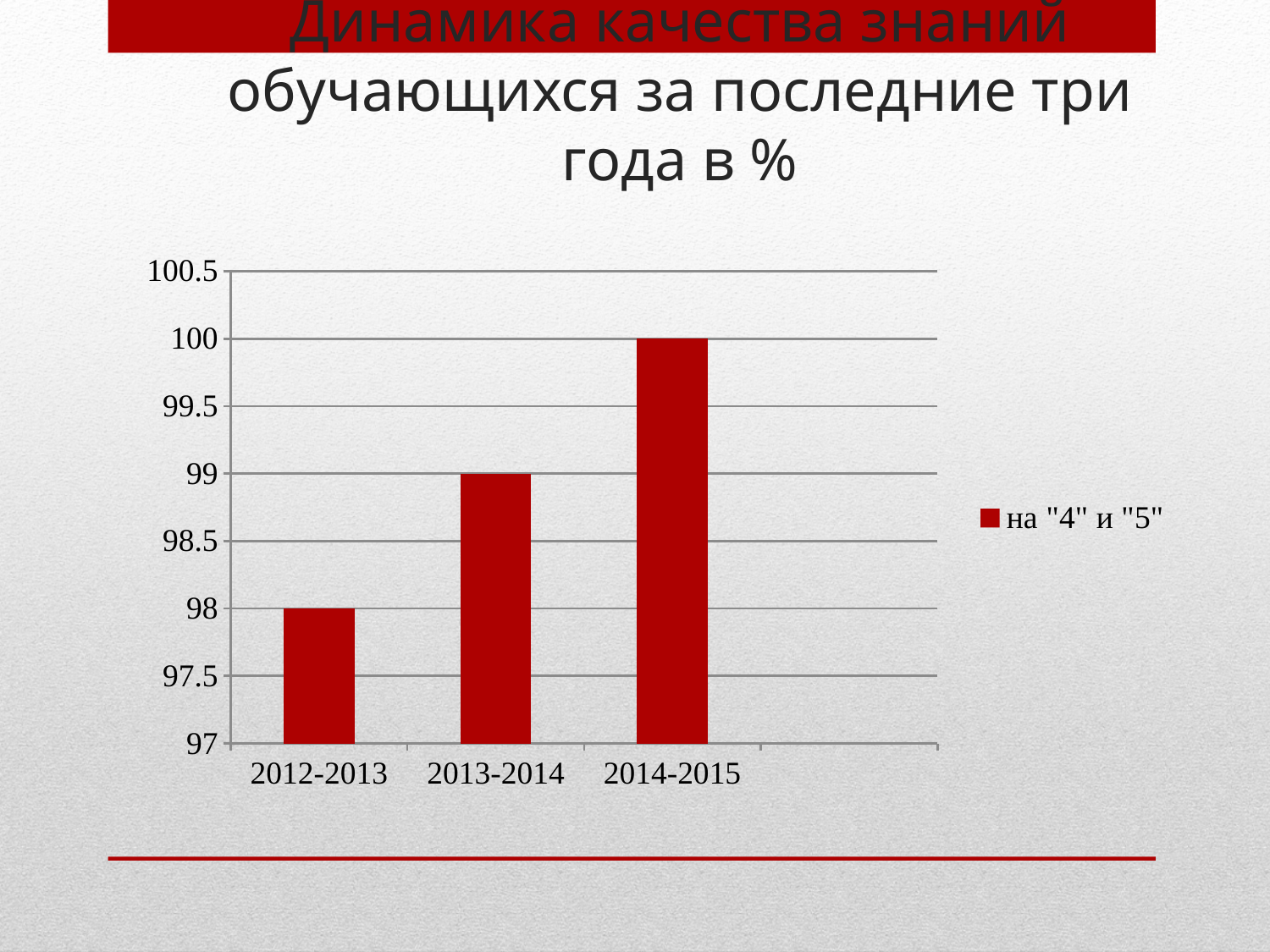
Do the values rise or fall from 2012-2013 to 2014-2015? rise Which year has the highest value? 2014-2015 How many years (categories) are shown on the x axis? 3 What is the value for 2012-2013? 98 What is the difference between the values for 2014-2015 and 2012-2013? 2 Which is larger, the value for 2013-2014 or the value for 2012-2013? 2013-2014 What type of chart is shown on the slide? bar chart Which year has the lowest value? 2012-2013 What is the value for 2014-2015? 100 What is the value for 2013-2014? 99 What is the legend entry for the series shown? на "4" и "5" Is the value for 2013-2014 greater or less than 98.5? greater